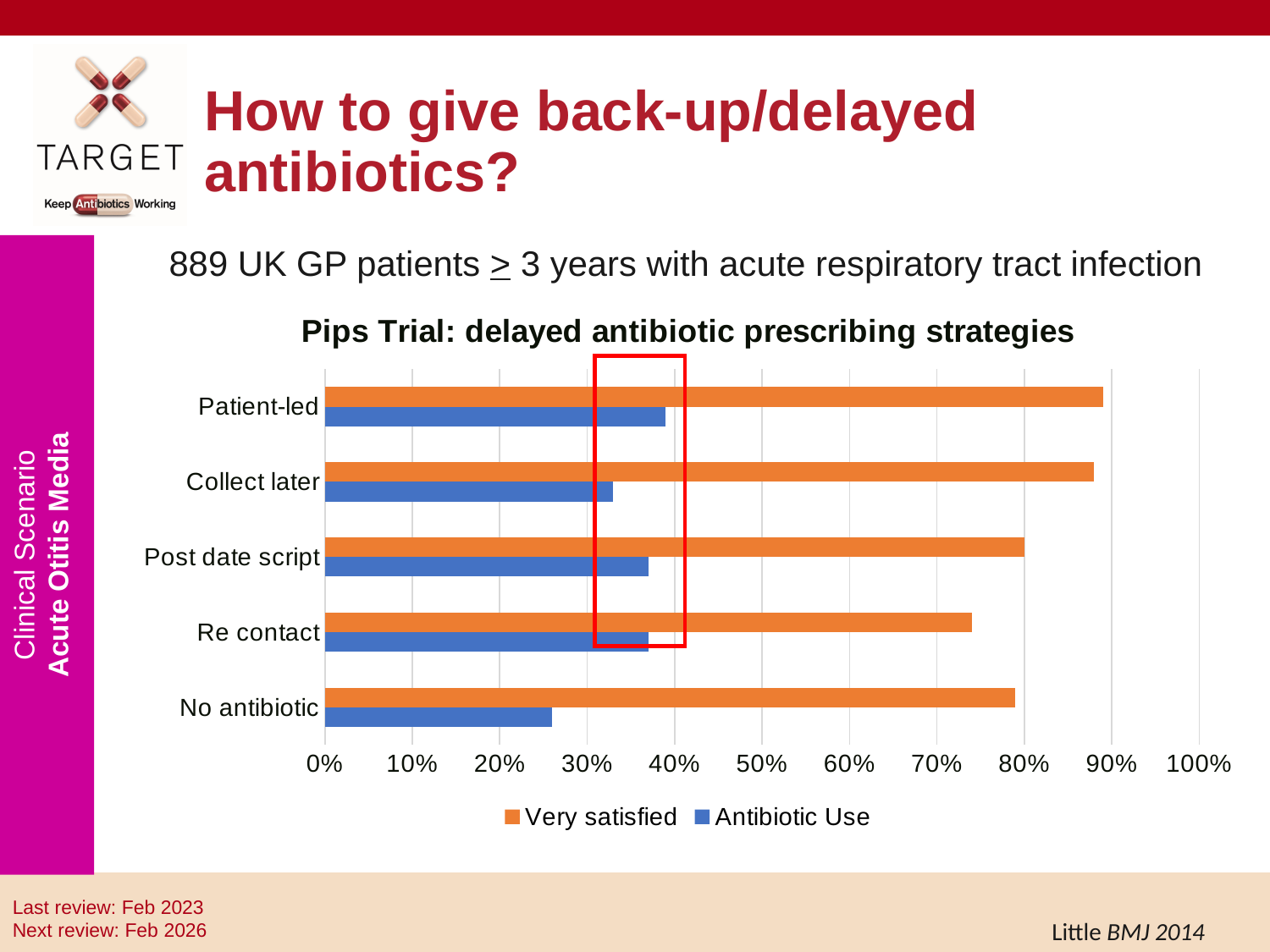
Is the 'Very satisfied' value for Re contact greater or less than 80%? less Which colour represents the 'Antibiotic Use' series? Blue Is the 'Antibiotic Use' value for Collect later greater or less than 40%? less What kind of chart is shown on the slide? Bar chart How many prescribing strategies (categories) are shown on the chart? 5 Which has the larger 'Antibiotic Use' value: Collect later or Post date script? Post date script Which strategy has the lowest 'Very satisfied' value? Re contact What is the title of the chart? Pips Trial: delayed antibiotic prescribing strategies Which strategy has the lowest 'Antibiotic Use' value? No antibiotic Is the 'Very satisfied' value for Patient-led greater or less than 80%? greater How many series does the chart legend list? 2